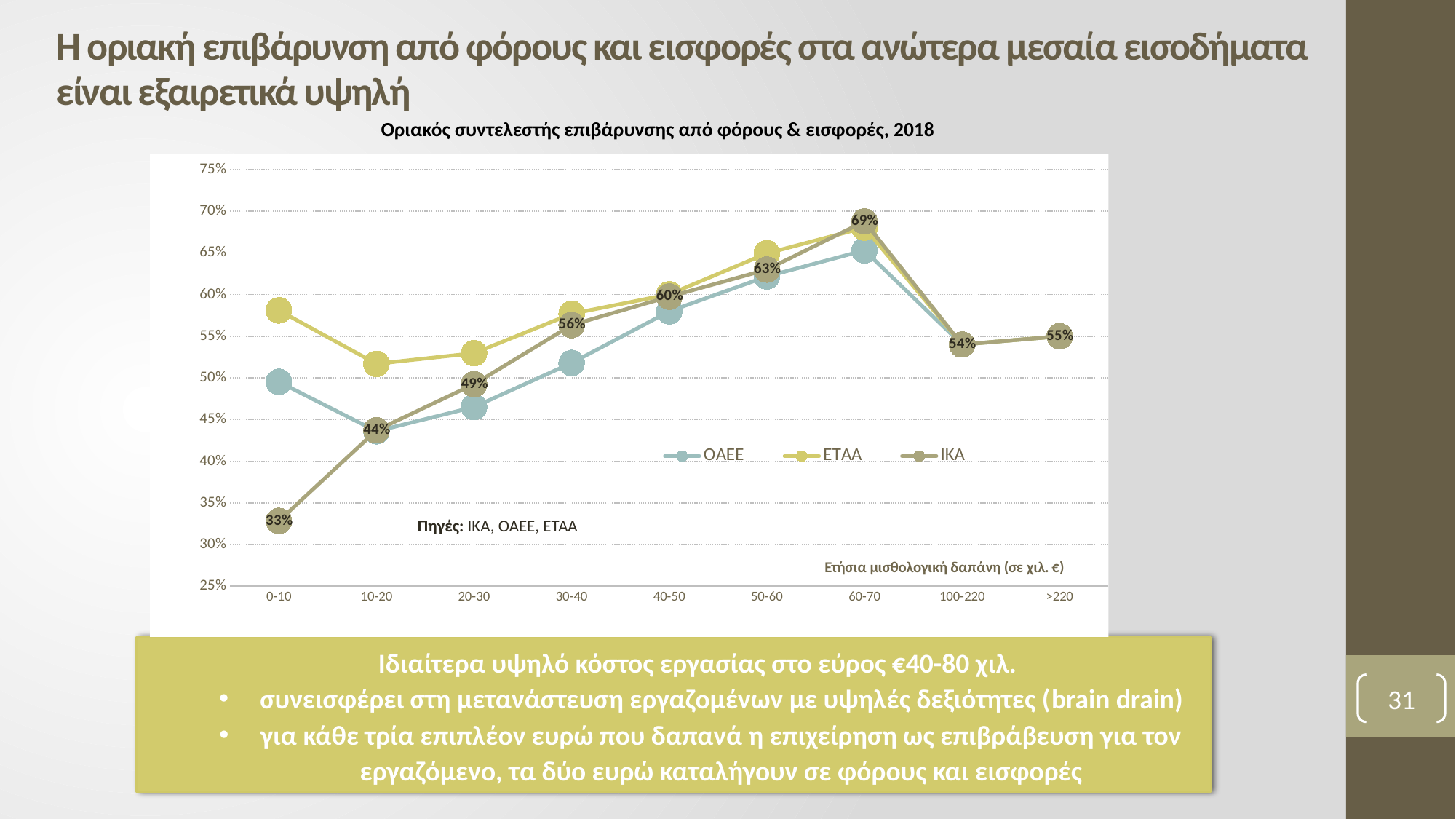
How many series does the legend list? 3 In which category does the IKA series reach its highest value? 60-70 What is the value for IKA in the 0-10 category? 33% In which category does the IKA series have its lowest value? 0-10 Does the IKA series rise or fall from the 0-10 category to the 60-70 category? Rises What is the difference between the IKA value at 60-70 and at 0-10? 36 percentage points How many income categories are shown on the x axis? 9 What is the value for IKA in the 60-70 category? 69% Is the value for OAEE in the 60-70 category greater or less than 60%? greater Is the value for ETAA in the 0-10 category greater or less than 55%? greater What type of chart is shown on the slide? Line chart What is the value for IKA in the 100-220 category? 54%